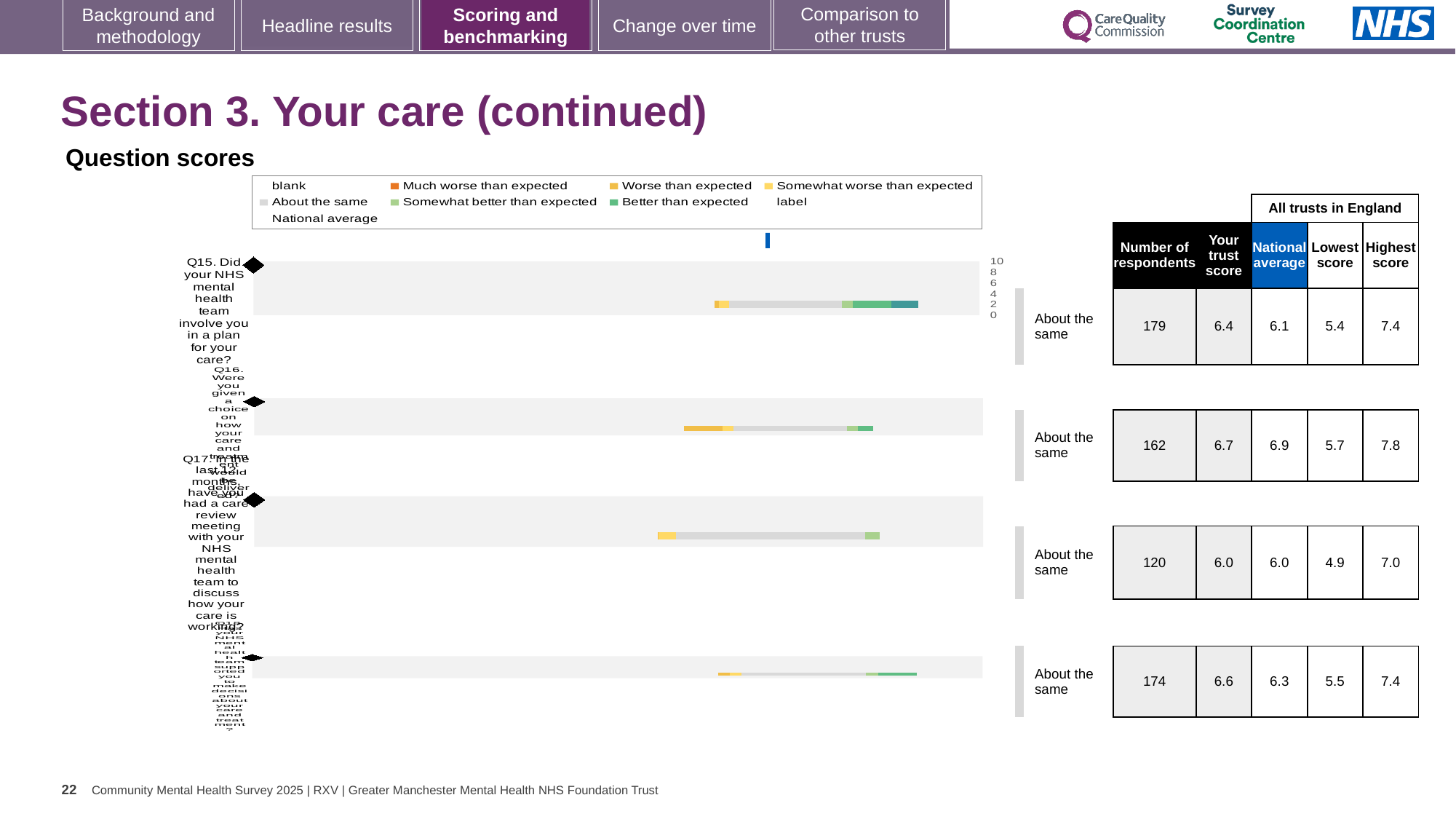
What benchmark category is shown next to each question bar in the chart? About the same Is the trust score for Q15 larger or smaller than the national average for Q15? larger In the question scores table, what is the trust score for Q16 (Were you given a choice on how your care and treatment would be delivered)? 6.7 What is the difference between the trust score and the national average for Q16? 0.2 In the question scores table, what is the number of respondents for Q15 (Did your NHS mental health team involve you in a plan for your care?)? 179 In the question scores table, what is the lowest score among all trusts in England for Q17? 4.9 Which question in the table has the lowest number of respondents? Q17 In the question scores table, what is the national average for Q17 (In the last 12 months, have you had a care review meeting)? 6.0 What kind of chart is used to show the question scores on this slide? bar chart Which question in the table has the highest number of respondents? Q15 In the question scores table, what is the highest score among all trusts in England for Q16? 7.8 How many question bars are plotted in the question scores chart? 4